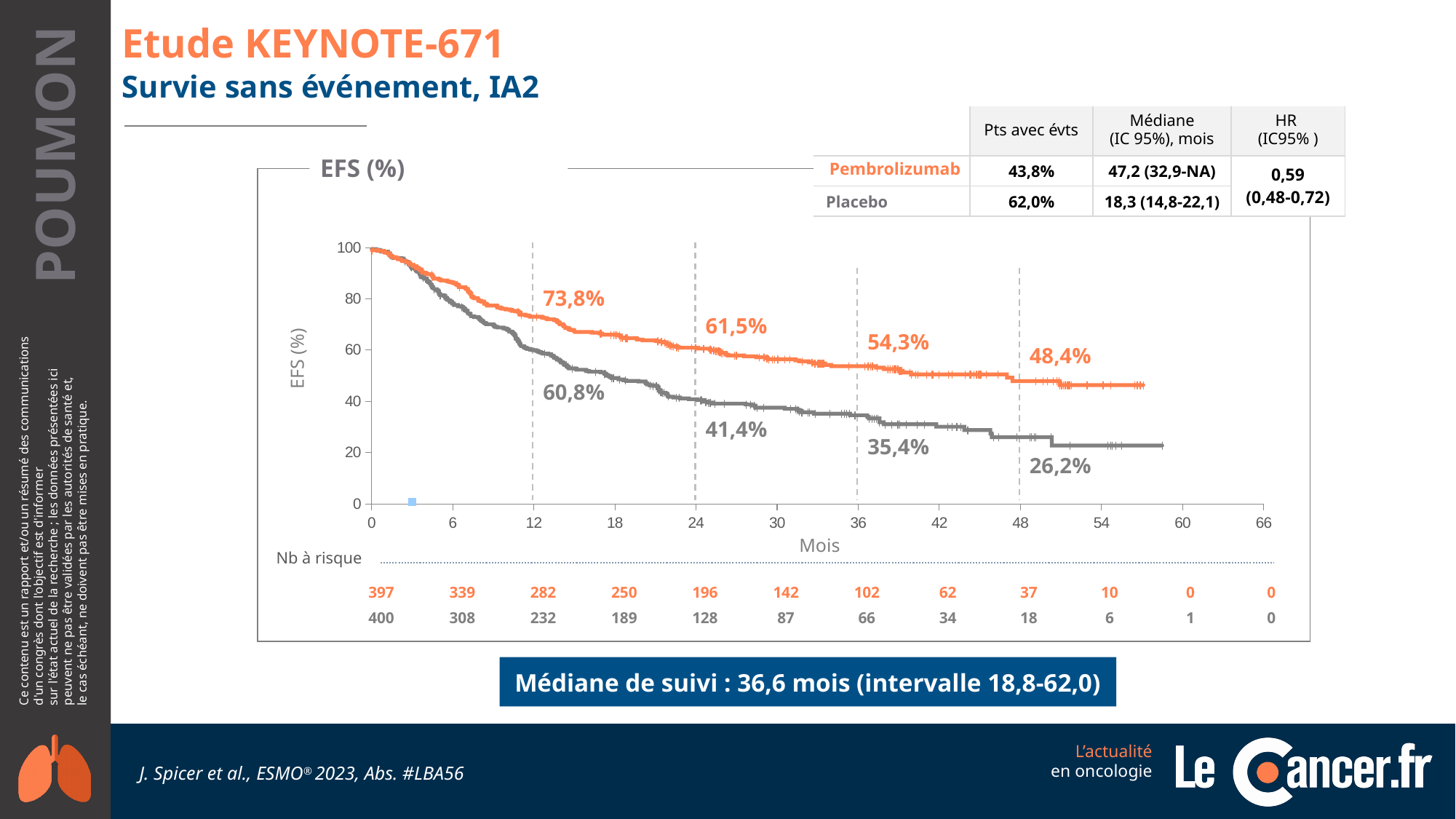
What is the difference between the pembrolizumab and placebo EFS rates at 36 months? 18,9% Does the EFS curve for placebo rise or fall as months increase? Fall What kind of chart is shown on the slide? Line chart (Kaplan-Meier curve) Which arm has the higher EFS rate at 48 months, pembrolizumab or placebo? Pembrolizumab What is the EFS rate for pembrolizumab at 48 months? 48,4% What is the label of the x axis of the chart? Mois How many patients were at risk in the placebo arm at 24 months? 128 What is the EFS rate for placebo at 24 months? 41,4% What is the EFS rate for placebo at 36 months? 35,4% What is the EFS rate for pembrolizumab at 12 months? 73,8% What colour is the pembrolizumab curve? Orange How many patients were at risk in the pembrolizumab arm at 0 months? 397